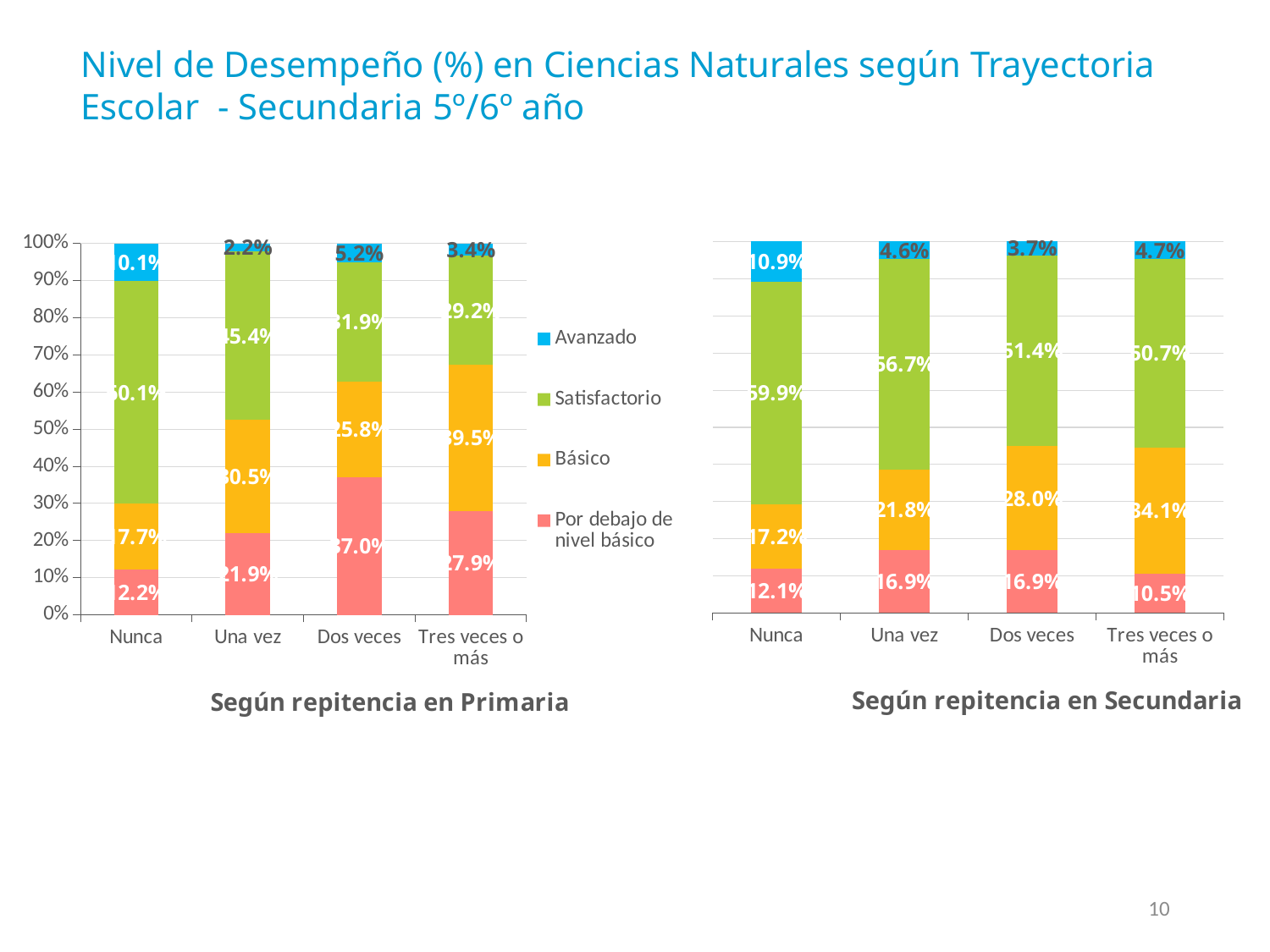
In the 'Según repitencia en Secundaria' chart, what is the difference between the Básico value for Tres veces o más and for Nunca? 16.9 percentage points In the 'Según repitencia en Secundaria' chart, what is the Avanzado value for Nunca? 10.9% What kind of chart is used on this slide for 'Según repitencia en Primaria'? Stacked bar chart In the 'Según repitencia en Primaria' chart, which category has the lowest Avanzado value? Una vez How many series does the legend list? 4 In the 'Según repitencia en Secundaria' chart, how many categories are shown on the x axis? 4 In the 'Según repitencia en Primaria' chart, what is the Avanzado value for Dos veces? 5.2% In the 'Según repitencia en Secundaria' chart, does the Satisfactorio value rise or fall from Nunca to Tres veces o más? Fall In the 'Según repitencia en Primaria' chart, what is the 'Por debajo de nivel básico' value for Dos veces? 37.0% In the 'Según repitencia en Secundaria' chart, which category has the highest Avanzado value? Nunca In the 'Según repitencia en Secundaria' chart, which is larger: the 'Por debajo de nivel básico' value for Nunca or for Tres veces o más? Nunca In the 'Según repitencia en Secundaria' chart, what is the Básico value for Tres veces o más? 34.1%